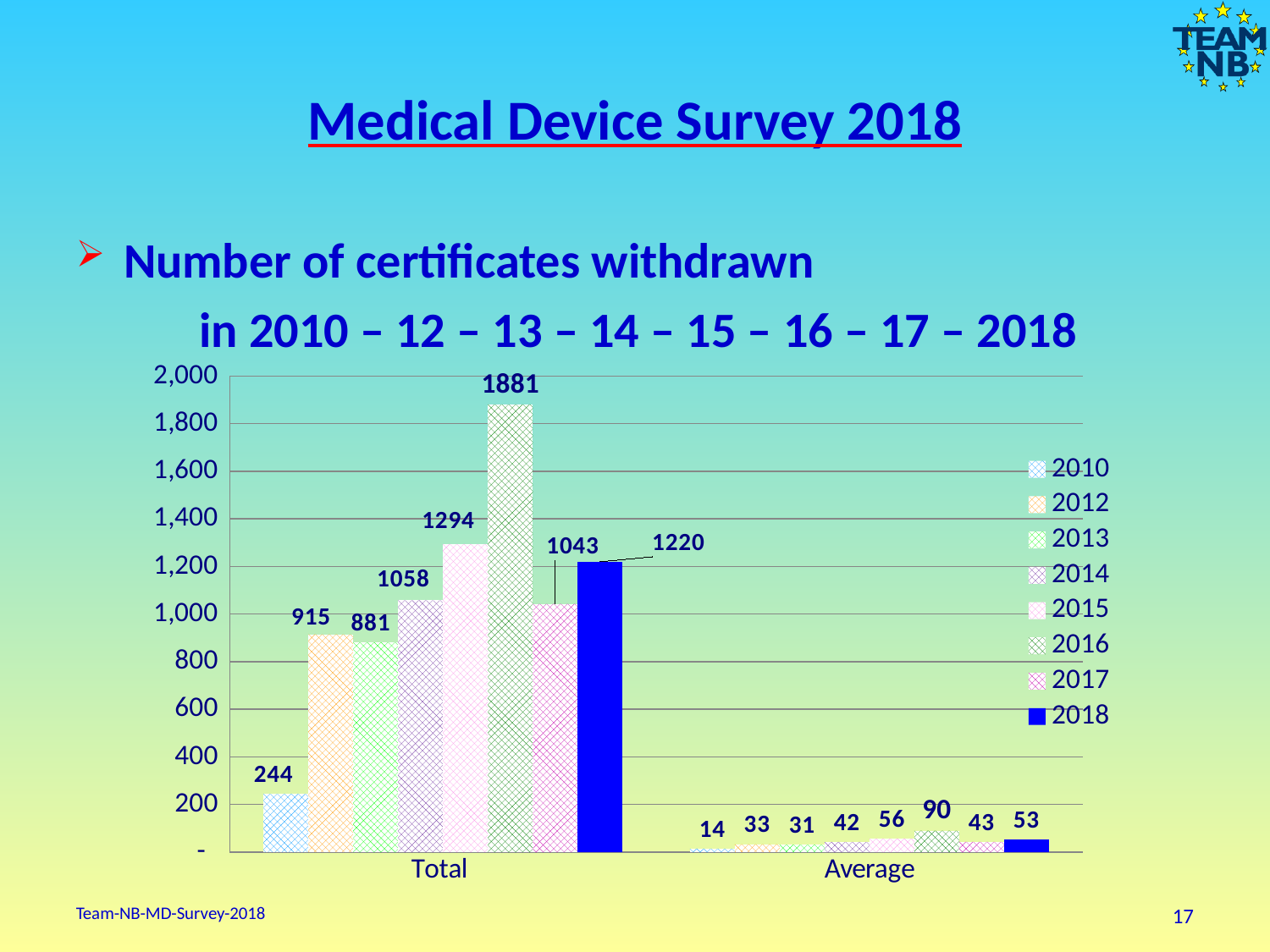
What is the difference between the Total values for 2016 and 2018? 661 What is the Average value shown for 2018? 53 Which is larger, the Total value for 2015 or the Total value for 2017? 2015 Which series is drawn as a solid blue bar? 2018 What is the Total value shown for 2010? 244 Is the Total value for 2014 greater or less than 1,000? greater What kind of chart is shown on the slide? bar chart Which year has the highest Total number of certificates withdrawn? 2016 How many series does the legend list? 8 How many categories are shown on the x axis? 2 Which year has the lowest Average value? 2010 What is the Total number of certificates withdrawn for 2016? 1881